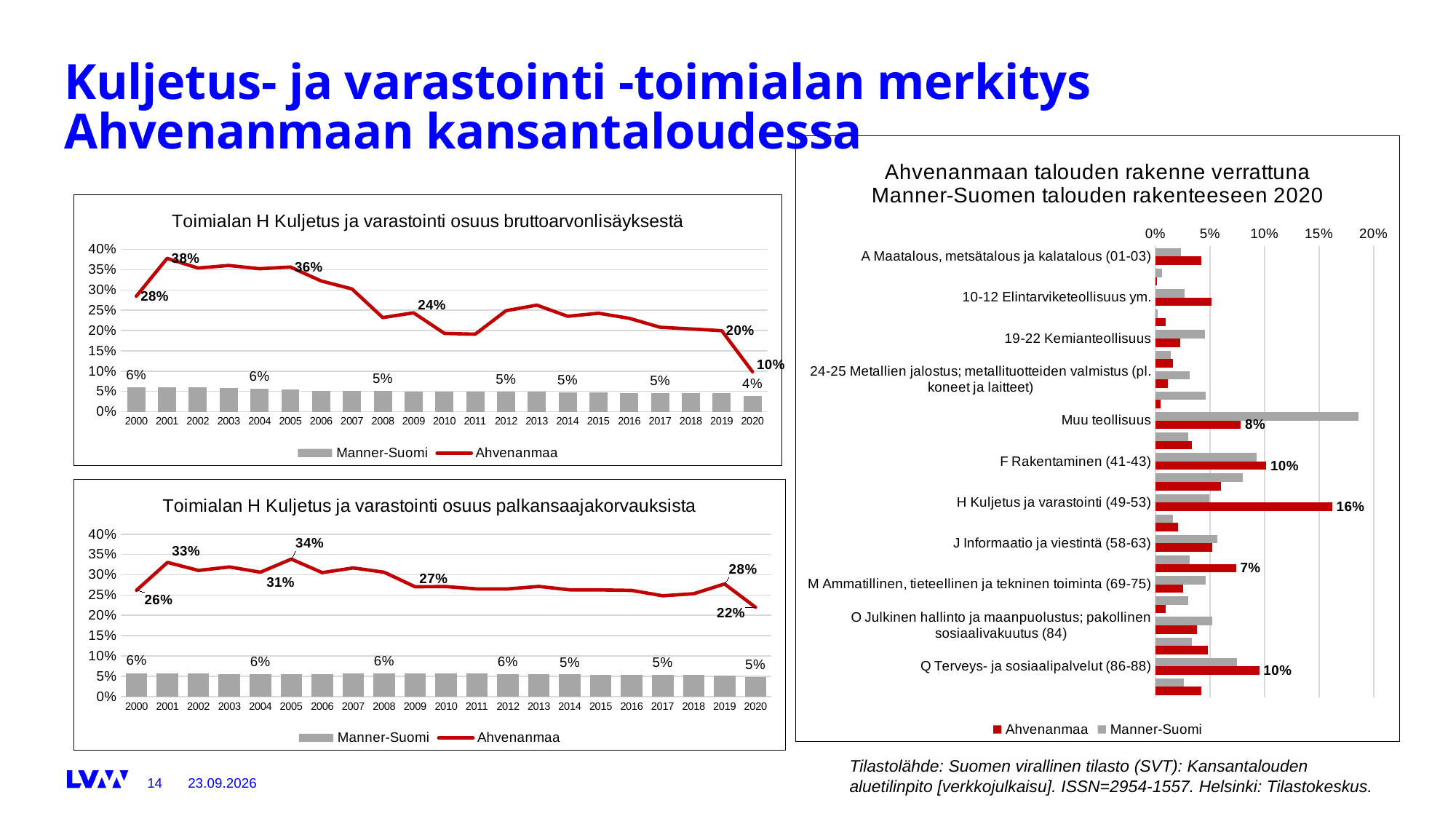
In the chart 'Toimialan H Kuljetus ja varastointi osuus palkansaajakorvauksista', which is larger in 2000: the Ahvenanmaa value or the Manner-Suomi value? Ahvenanmaa In the chart 'Ahvenanmaan talouden rakenne verrattuna Manner-Suomen talouden rakenteeseen 2020', what is the Ahvenanmaa value for 'F Rakentaminen (41-43)'? 10% In the chart 'Toimialan H Kuljetus ja varastointi osuus bruttoarvonlisäyksestä', what is the Ahvenanmaa value for 2020? 10% In the chart 'Toimialan H Kuljetus ja varastointi osuus palkansaajakorvauksista', what is the Ahvenanmaa value for 2005? 34% In the chart 'Toimialan H Kuljetus ja varastointi osuus palkansaajakorvauksista', what is the Ahvenanmaa value for 2020? 22% In the chart 'Toimialan H Kuljetus ja varastointi osuus bruttoarvonlisäyksestä', what is the Ahvenanmaa value for 2001? 38% In the chart 'Toimialan H Kuljetus ja varastointi osuus bruttoarvonlisäyksestä', how many series does the legend list? 2 In the chart 'Ahvenanmaan talouden rakenne verrattuna Manner-Suomen talouden rakenteeseen 2020', what is the Ahvenanmaa value for 'H Kuljetus ja varastointi (49-53)'? 16% In the chart 'Toimialan H Kuljetus ja varastointi osuus bruttoarvonlisäyksestä', what is the Manner-Suomi value for 2020? 4% What kind of chart is 'Ahvenanmaan talouden rakenne verrattuna Manner-Suomen talouden rakenteeseen 2020'? Bar chart In the chart 'Toimialan H Kuljetus ja varastointi osuus bruttoarvonlisäyksestä', what is the difference between the Ahvenanmaa values for 2019 and 2020? 10 percentage points In the chart 'Toimialan H Kuljetus ja varastointi osuus palkansaajakorvauksista', how many years are shown on the x axis? 21